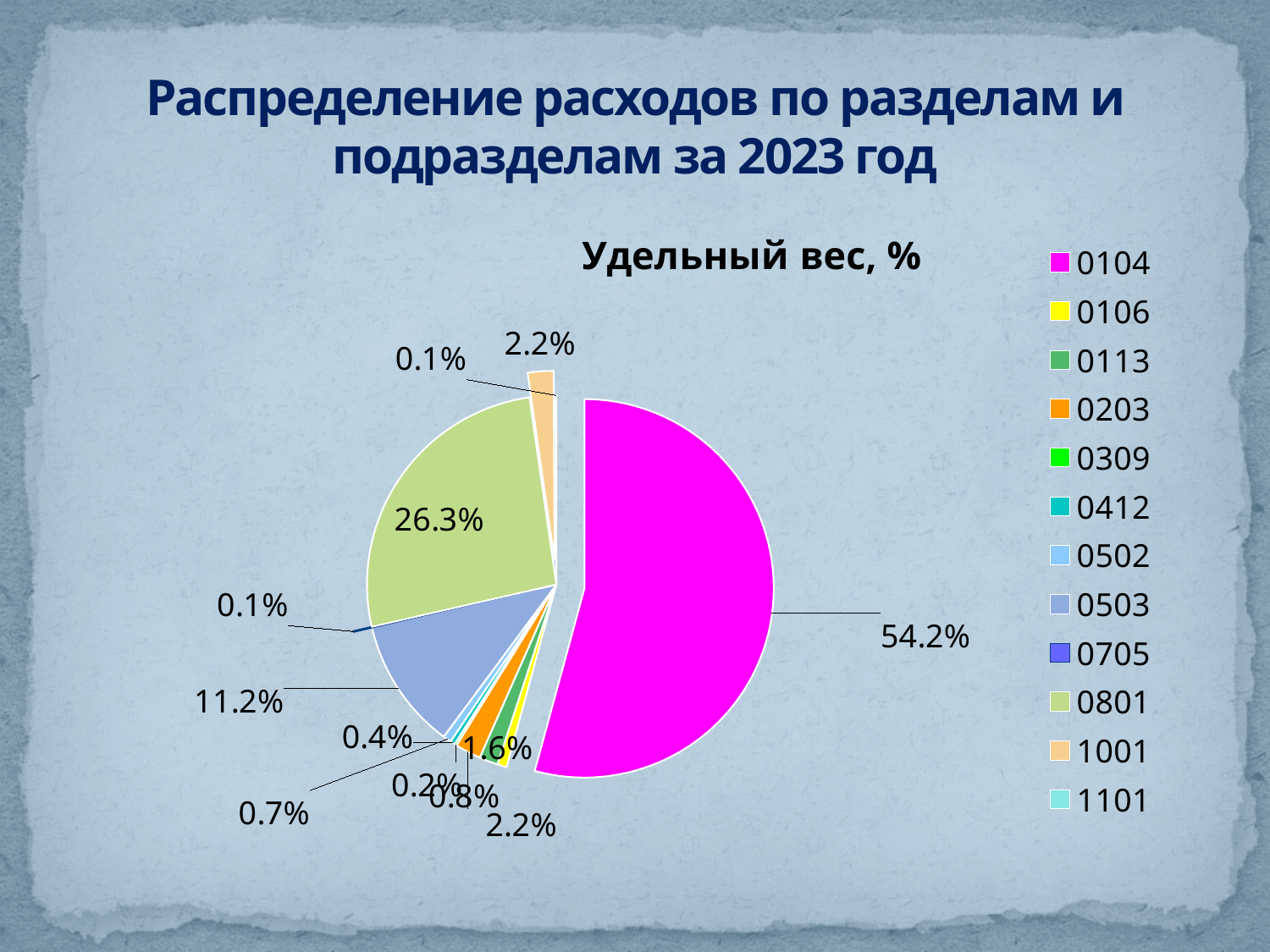
What is the difference between the values for 0104 and 0801? 27.9% What is the difference between the values for 0801 and 0503? 15.1% Which is larger, the slice for 0801 or the slice for 0503? 0801 What is the value shown for category 0801? 26.3% What is the title of the chart? Удельный вес, % What is the value shown for category 0503? 11.2% Which category has the largest slice of the pie? 0104 What colour is the slice for category 0104? magenta What share of the pie does category 0104 have? 54.2% How many categories does the legend of the pie chart list? 12 What kind of chart is shown on the slide? pie chart Is the share for category 0104 greater or less than 50%? greater